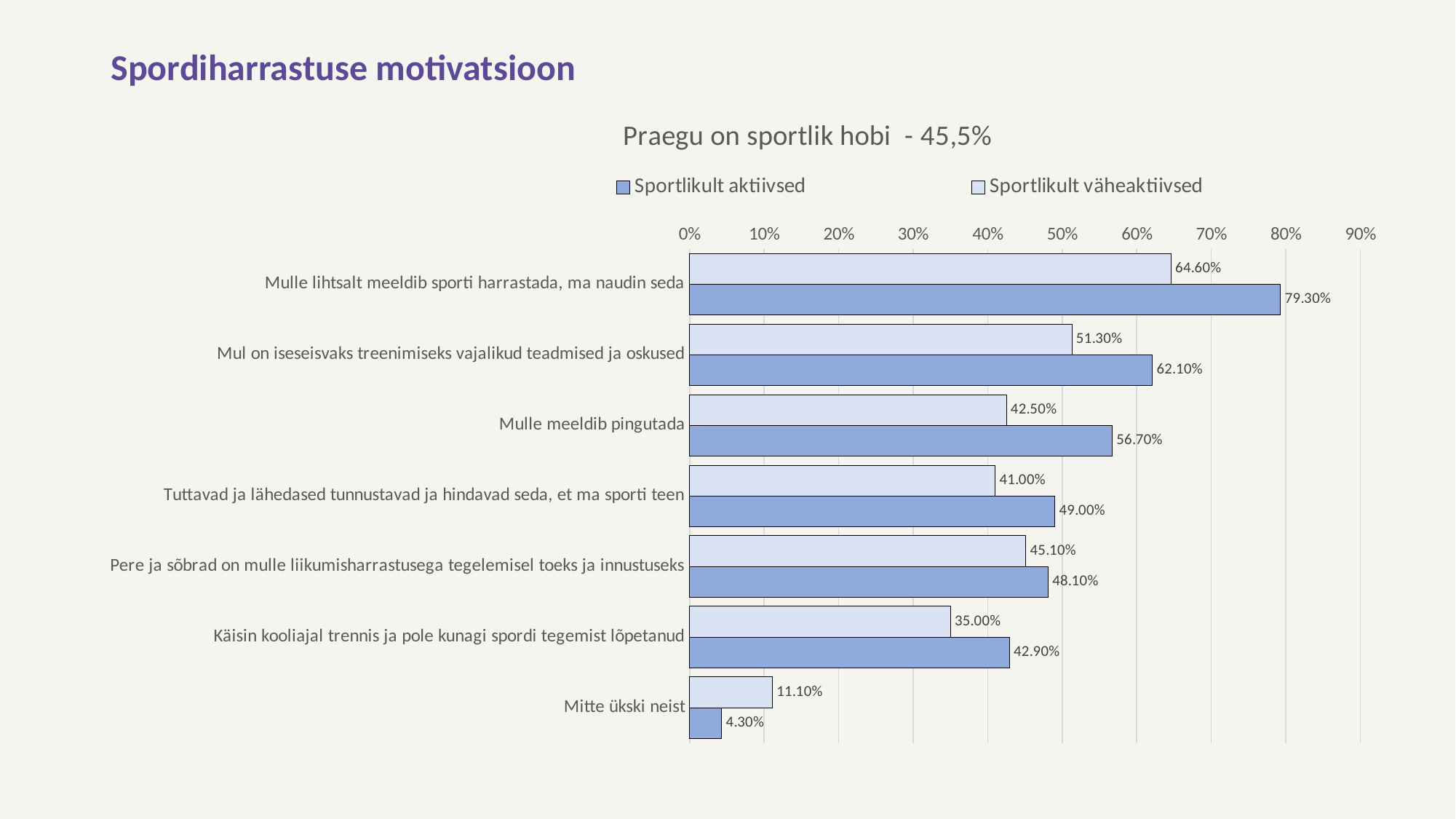
What is the value for "Sportlikult väheaktiivsed" for "Mulle meeldib pingutada"? 42.50% What is the value for "Sportlikult aktiivsed" for "Mitte ükski neist"? 4.30% What is the value for "Sportlikult aktiivsed" for "Mulle lihtsalt meeldib sporti harrastada, ma naudin seda"? 79.30% What is the difference between the "Sportlikult aktiivsed" and "Sportlikult väheaktiivsed" values for "Mul on iseseisvaks treenimiseks vajalikud teadmised ja oskused"? 10.80% For "Mitte ükski neist", which series has the larger value? Sportlikult väheaktiivsed Which category has the highest value for "Sportlikult väheaktiivsed"? Mulle lihtsalt meeldib sporti harrastada, ma naudin seda How many series does the legend list? 2 Is the "Sportlikult aktiivsed" value for "Käisin kooliajal trennis ja pole kunagi spordi tegemist lõpetanud" greater or less than 40%? greater How many categories are shown on the chart? 7 What is the title of the chart? Praegu on sportlik hobi - 45,5% Which category has the lowest value for "Sportlikult aktiivsed"? Mitte ükski neist What kind of chart is shown on the slide? Bar chart